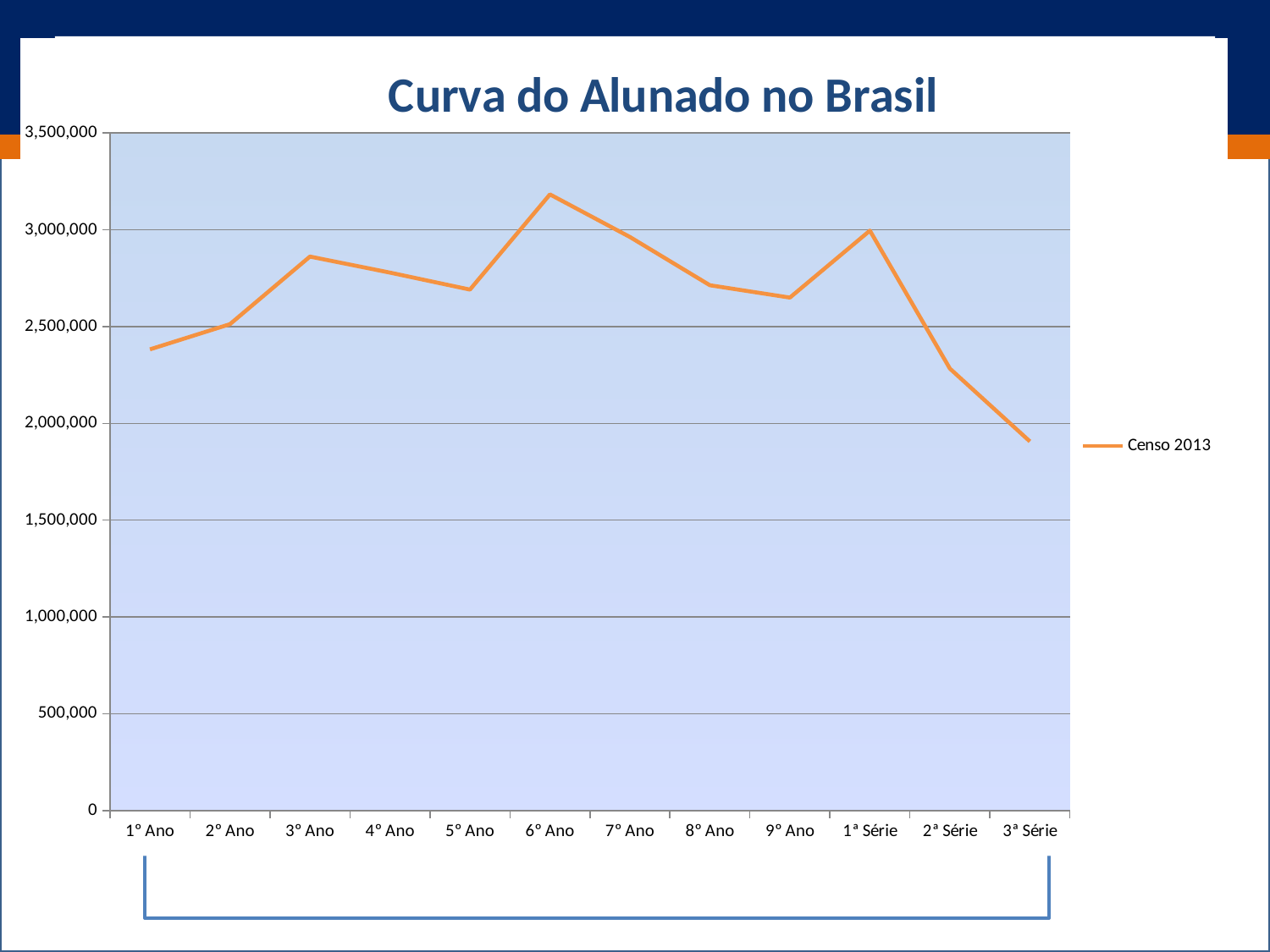
Which category has the highest value? 6° Ano What kind of chart is shown on the slide? line chart Is the value for 6° Ano greater or less than 3,000,000? greater Which category has the lowest value? 3ª Série Which is larger, the value for 1ª Série or the value for 2ª Série? 1ª Série How many series does the legend list? 1 Do the values rise or fall from 1ª Série to 3ª Série? fall What is the name of the series shown in the legend? Censo 2013 Is the value for 1° Ano greater or less than 2,500,000? less Is the value for 3ª Série greater or less than 2,000,000? less What is the title of the chart? Curva do Alunado no Brasil How many categories are shown on the x axis? 12